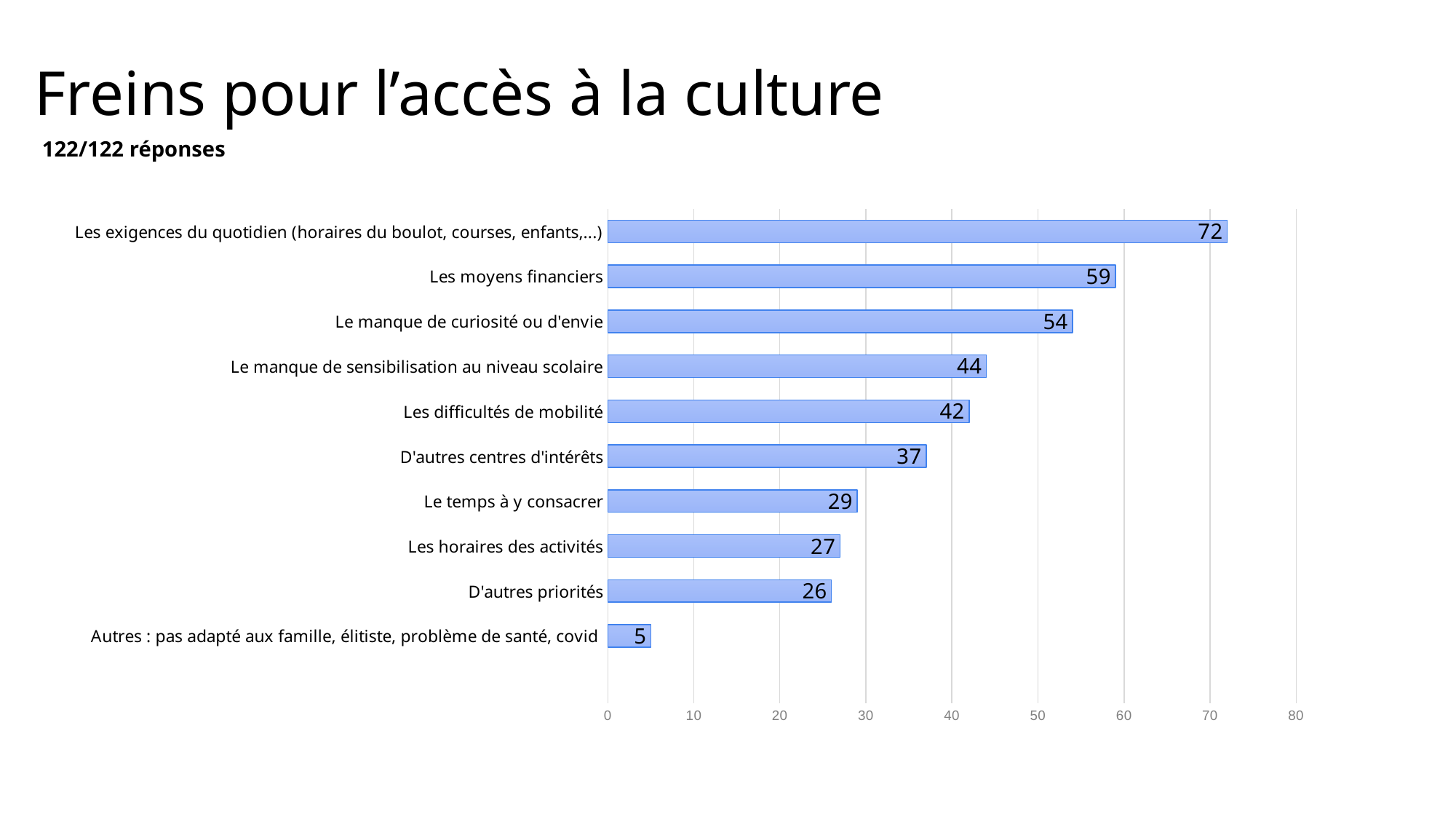
What is the difference between the values for "Le manque de sensibilisation au niveau scolaire" and "D'autres centres d'intérêts"? 7 What is the value for "Les moyens financiers"? 59 What is the value for "Le temps à y consacrer"? 29 What is the difference between the values for "Les exigences du quotidien (horaires du boulot, courses, enfants,...)" and "Les moyens financiers"? 13 What is the value for "Les difficultés de mobilité"? 42 Which category has the lowest value? Autres : pas adapté aux famille, élitiste, problème de santé, covid What kind of chart is shown on the slide? bar chart Which is larger, the value for "Le manque de curiosité ou d'envie" or the value for "Les horaires des activités"? Le manque de curiosité ou d'envie How many categories are shown in the chart? 10 Which category has the highest value? Les exigences du quotidien (horaires du boulot, courses, enfants,...) Is the value for "D'autres priorités" greater or less than 30? less What is the title of the slide? Freins pour l’accès à la culture